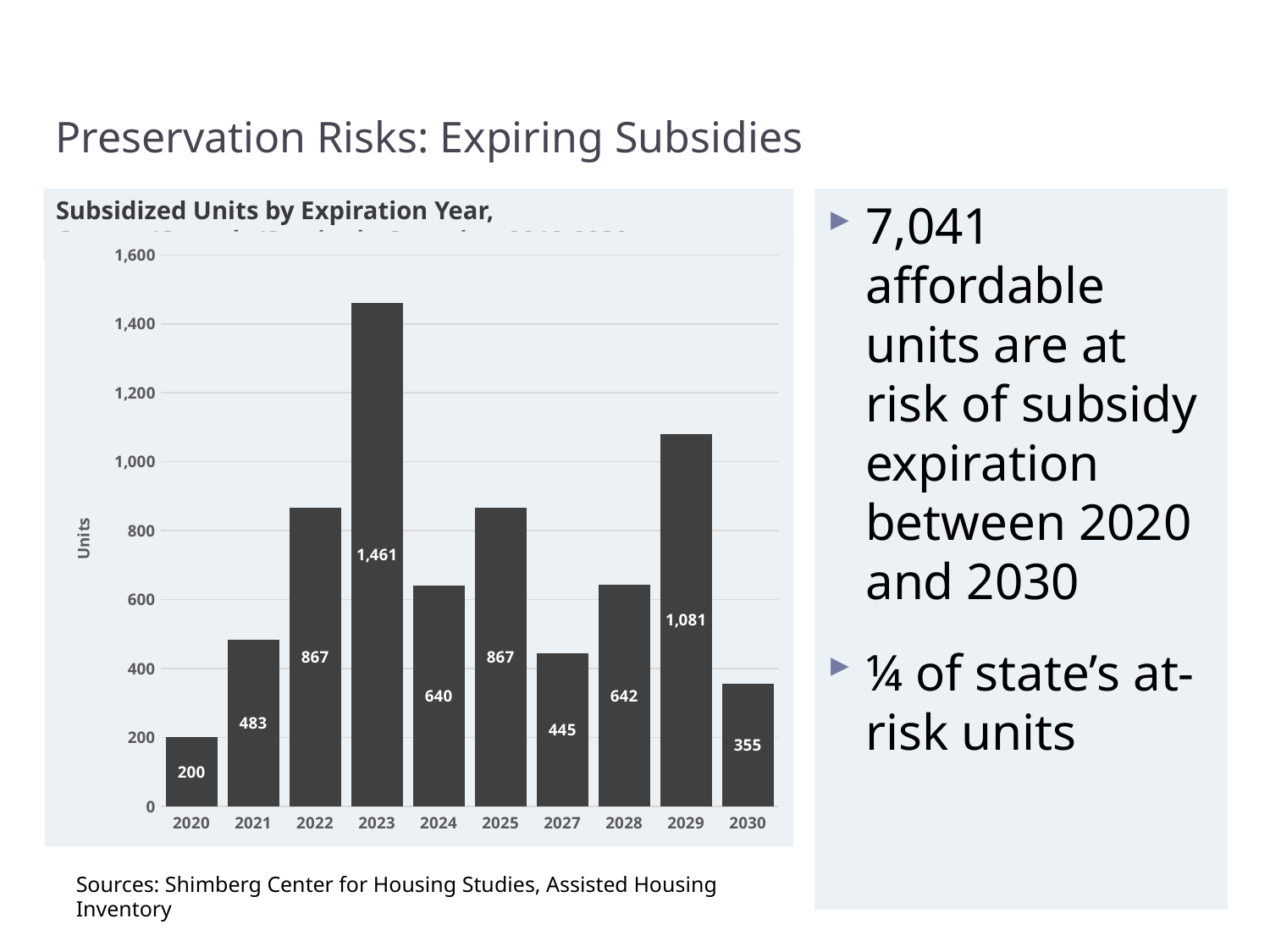
Which year has the lowest number of units? 2020 How many years are shown on the x axis of the chart? 10 How many units are shown for 2020? 200 Which year has more units, 2021 or 2030? 2021 What is the difference in units between 2028 and 2027? 197 How many units are shown for 2023? 1,461 How many units are shown for 2029? 1,081 Which year has the highest number of units? 2023 What is the difference in units between 2023 and 2029? 380 What is the label on the vertical axis of the chart? Units What type of chart is shown on the slide? Bar chart Is the value for 2025 greater or less than 800? greater